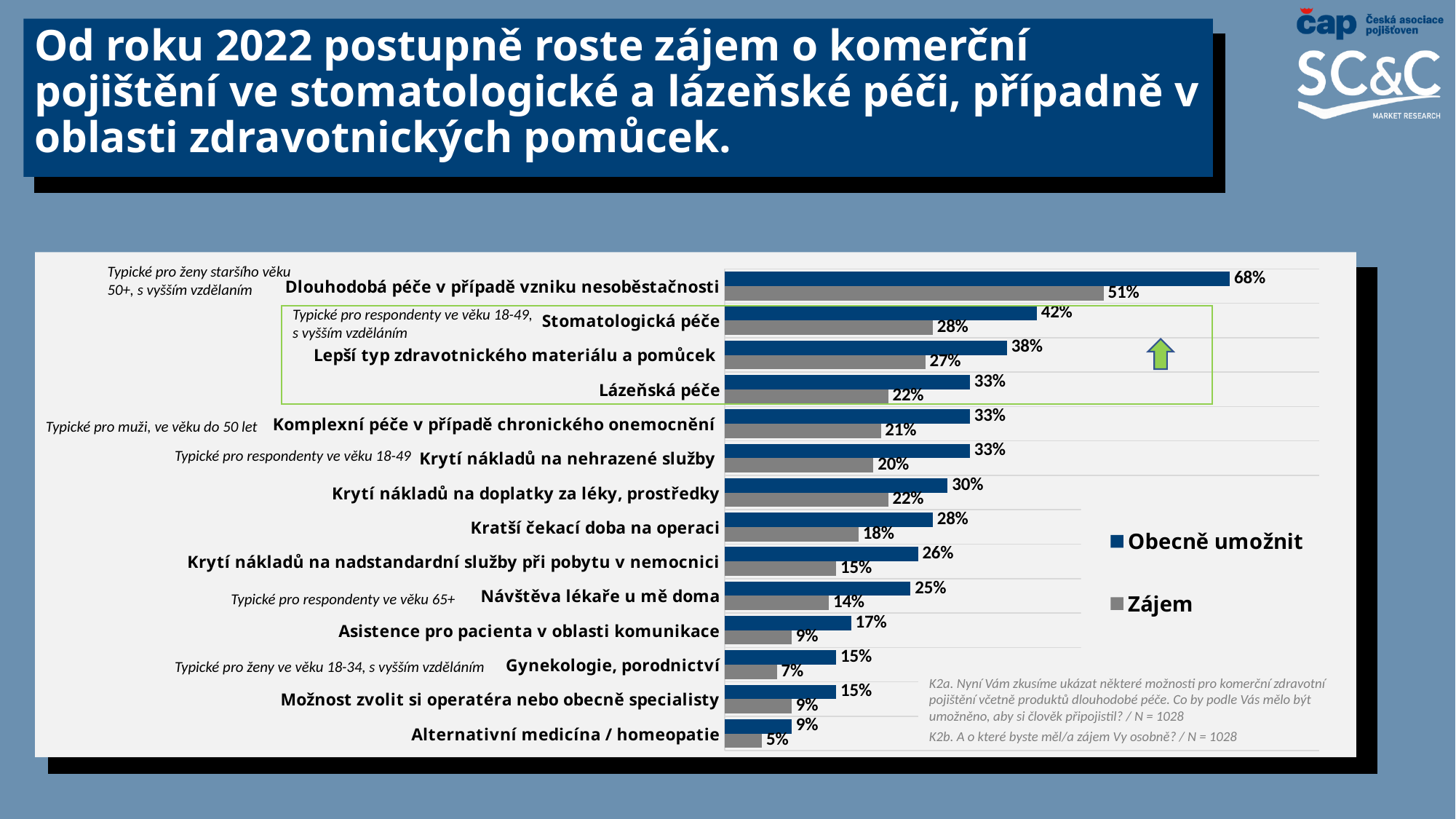
What is the "Obecně umožnit" value for "Stomatologická péče"? 42% What type of chart is shown on the slide? Bar chart Which is larger: the "Zájem" value for "Stomatologická péče" or for "Kratší čekací doba na operaci"? Stomatologická péče How many series does the legend list? 2 What are the two series named in the legend? Obecně umožnit and Zájem Which category has the highest "Obecně umožnit" value? Dlouhodobá péče v případě vzniku nesoběstačnosti What is the "Obecně umožnit" value for "Gynekologie, porodnictví"? 15% Which category has the lowest "Zájem" value? Alternativní medicína / homeopatie How many categories are shown in the chart? 14 What is the difference between the "Obecně umožnit" and "Zájem" values for "Dlouhodobá péče v případě vzniku nesoběstačnosti"? 17 percentage points What is the "Zájem" value for "Lázeňská péče"? 22% What is the "Zájem" value for "Návštěva lékaře u mě doma"? 14%